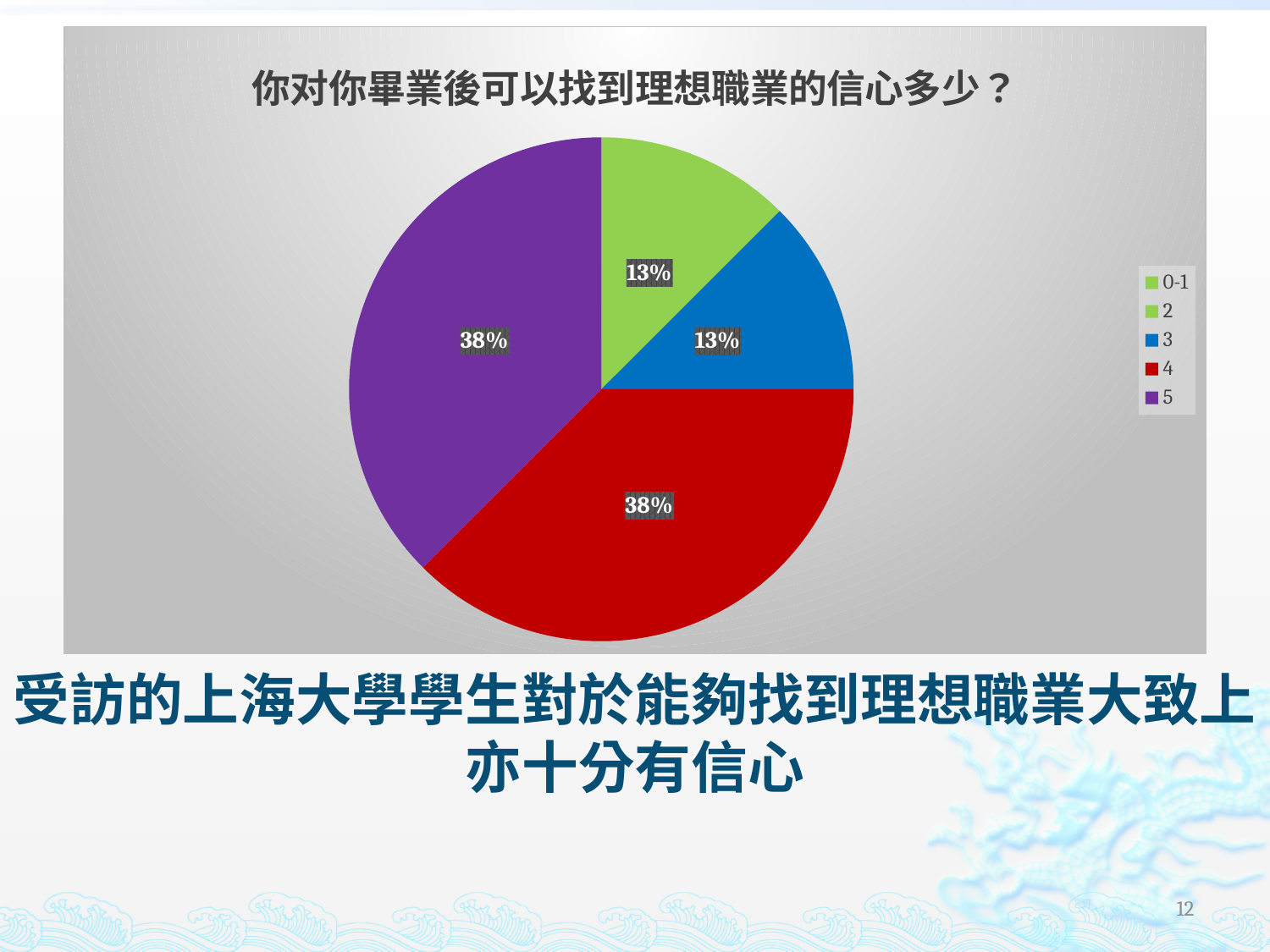
What colour is the slice for category "5"? purple What percentage of the pie does the category "5" represent? 38% Which is larger, the share for category "5" or the share for category "3"? 5 What percentage of the pie does the category "4" represent? 38% What type of chart is shown on the slide? pie chart What percentage of the pie does the category "3" represent? 13% How many entries does the legend list? 5 What is the title of the pie chart? 你对你畢業後可以找到理想職業的信心多少？ What is the difference in percentage points between the share for category "5" and the share for category "3"? 25 What is the combined share of categories "4" and "5"? 76% What percentage of the pie does the category "2" represent? 13% Which is larger, the share for category "4" or the share for category "2"? 4